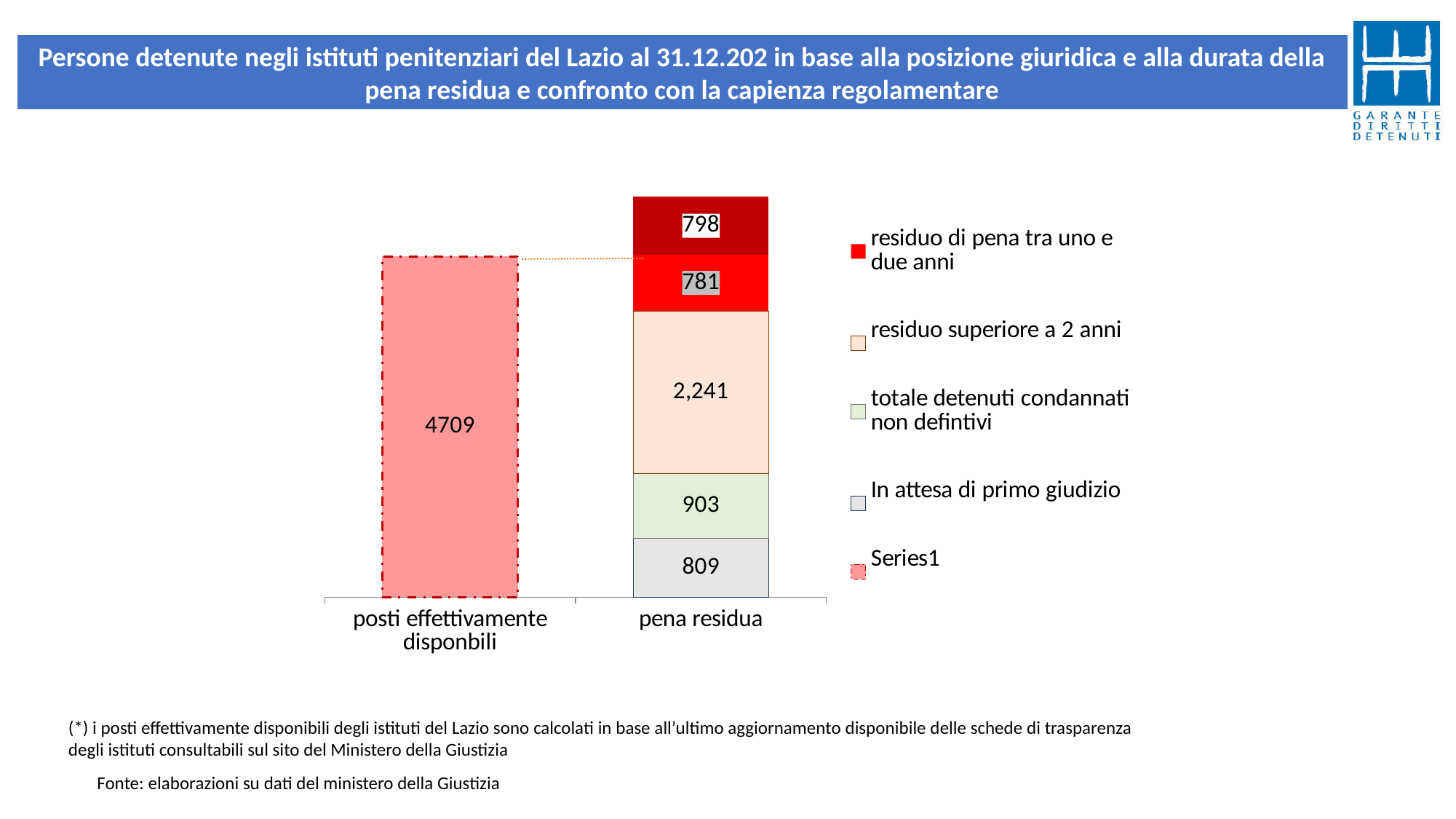
In the 'pena residua' bar, what is the value of the 'totale detenuti condannati non defintivi' segment? 903 In the 'pena residua' bar, what is the value of the 'residuo di pena tra uno e due anni' segment? 781 In the 'pena residua' bar, what is the value of the 'residuo superiore a 2 anni' segment? 2,241 Which segment of the 'pena residua' bar has the largest value? residuo superiore a 2 anni What is the total of all segments in the 'pena residua' stacked bar? 5532 What is the value shown for 'posti effettivamente disponbili'? 4709 What is the difference between the 'residuo superiore a 2 anni' segment and the 'totale detenuti condannati non defintivi' segment? 1338 Which labelled legend segment of the 'pena residua' bar has the smallest value? residuo di pena tra uno e due anni Which is larger in the 'pena residua' bar: 'totale detenuti condannati non defintivi' or 'In attesa di primo giudizio'? totale detenuti condannati non defintivi How many entries does the legend list? 5 In the 'pena residua' bar, what is the value of the 'In attesa di primo giudizio' segment? 809 How many categories are shown on the x axis? 2